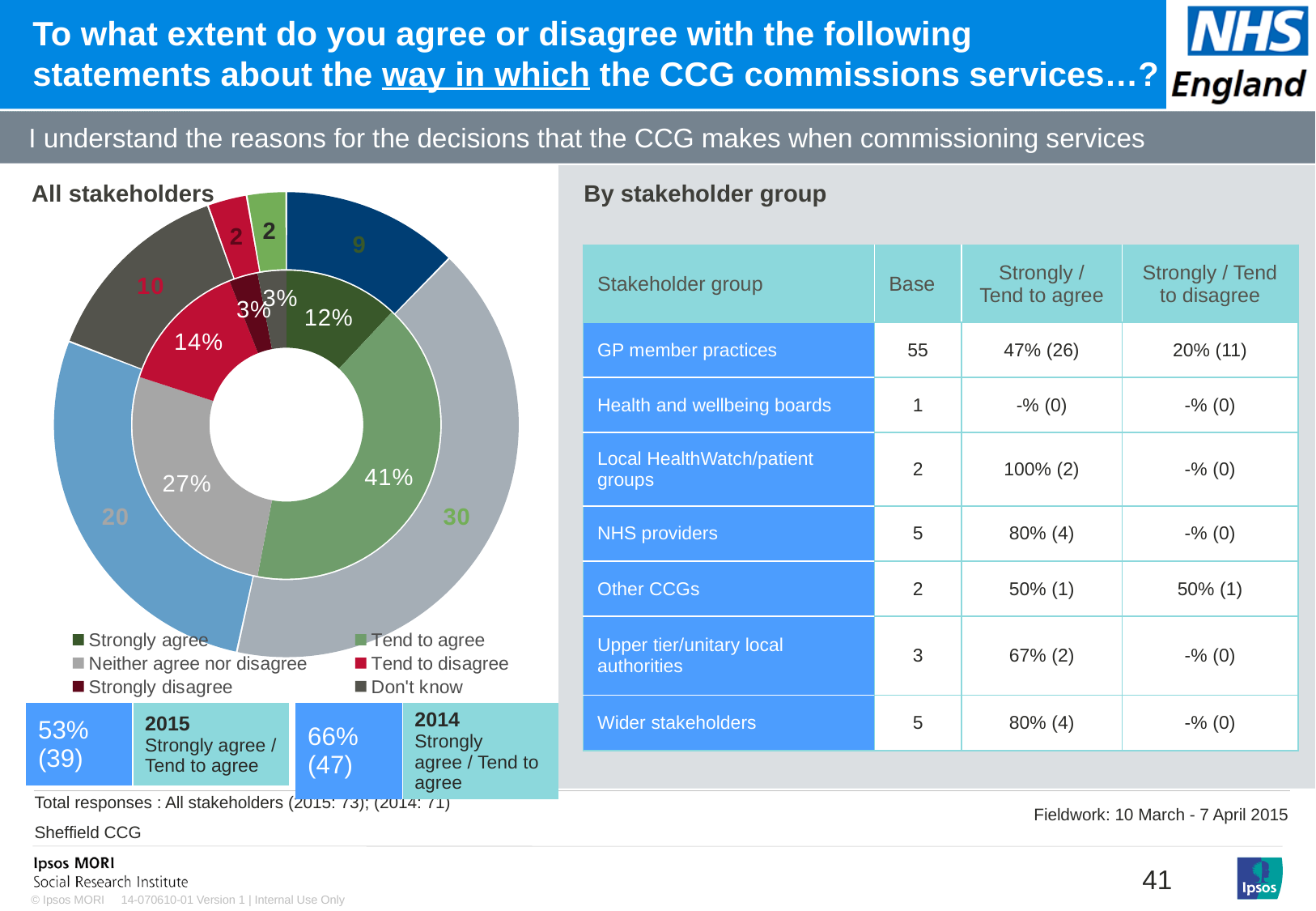
In the 'All stakeholders' doughnut chart, what value is shown for 'Neither agree nor disagree' in the outer ring? 20 In the 'All stakeholders' doughnut chart, what percentage is shown for 'Neither agree nor disagree' in the inner ring? 27% What type of chart is the 'All stakeholders' chart? Doughnut chart In the 'All stakeholders' doughnut chart, what percentage is shown for 'Strongly agree' in the inner ring? 12% In the 'All stakeholders' doughnut chart, what percentage is shown for 'Tend to agree' in the inner ring? 41% In the 'All stakeholders' doughnut chart, which category has the largest share in the inner ring? Tend to agree In the 'All stakeholders' doughnut chart, what value is shown for 'Tend to agree' in the outer ring? 30 In the 'All stakeholders' doughnut chart, what is the difference between the inner-ring percentages for 'Tend to agree' and 'Neither agree nor disagree'? 14% In the 'All stakeholders' doughnut chart, what value is shown for 'Tend to disagree' in the outer ring? 10 In the 'All stakeholders' doughnut chart, which is larger in the inner ring: 'Strongly agree' or 'Tend to disagree'? Tend to disagree How many categories does the legend of the 'All stakeholders' chart list? 6 In the 'All stakeholders' doughnut chart, what percentage is shown for 'Tend to disagree' in the inner ring? 14%